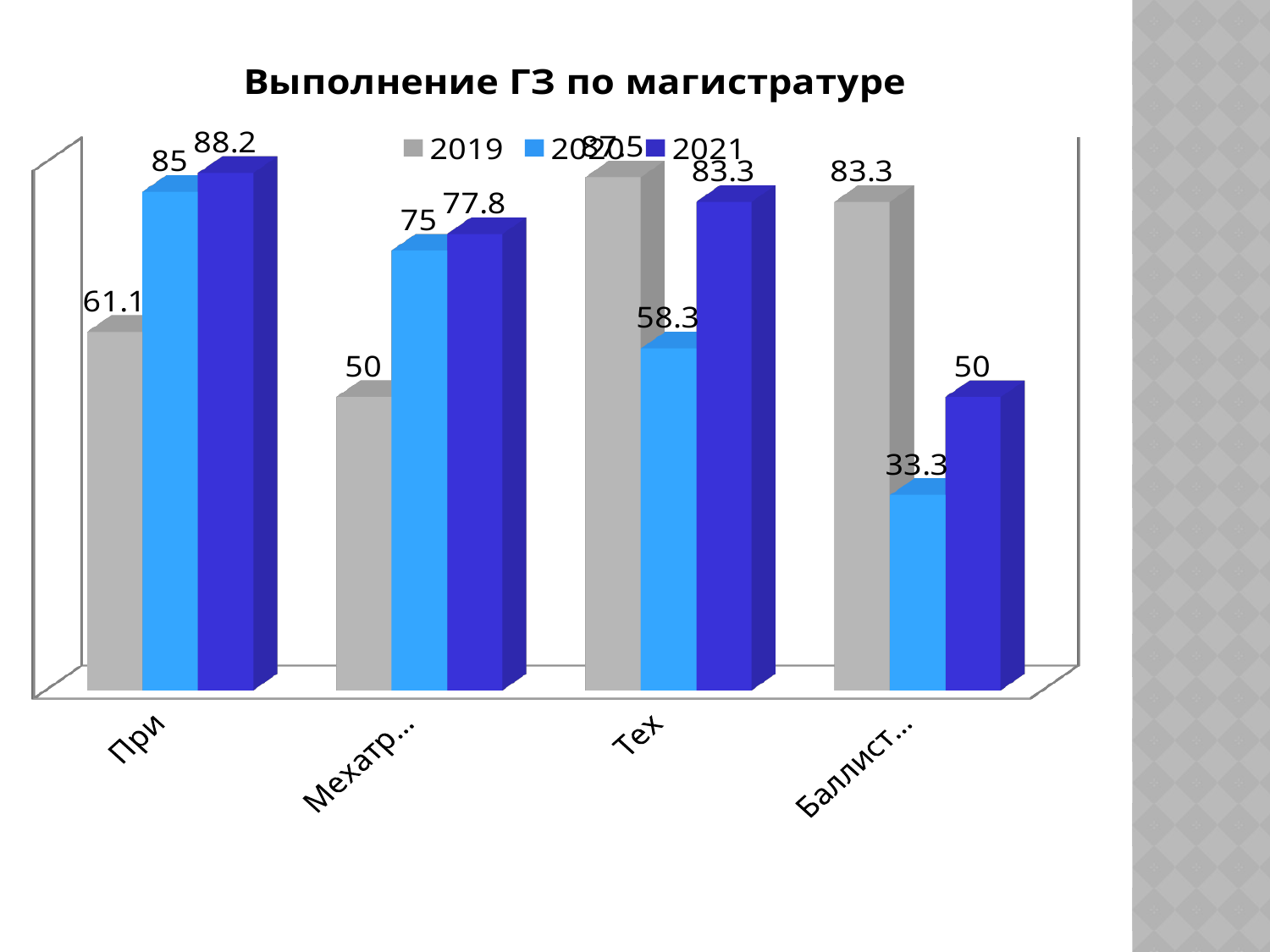
How many series does the legend list? 3 In the category Баллист..., which is larger: the 2019 value or the 2021 value? 2019 What is the value for 2021 in the category При? 88.2 What is the title of the chart? Выполнение ГЗ по магистратуре What kind of chart is shown on the slide? bar chart How many categories are shown on the x axis? 4 Which category has the lowest value for the 2020 series? Баллист... What is the value for 2019 in the category При? 61.1 What is the value for 2020 in the category Баллист...? 33.3 What is the value for 2020 in the category Тех? 58.3 What is the difference between the 2021 and 2019 values in the category Мехатр...? 27.8 Which category has the highest value for the 2021 series? При